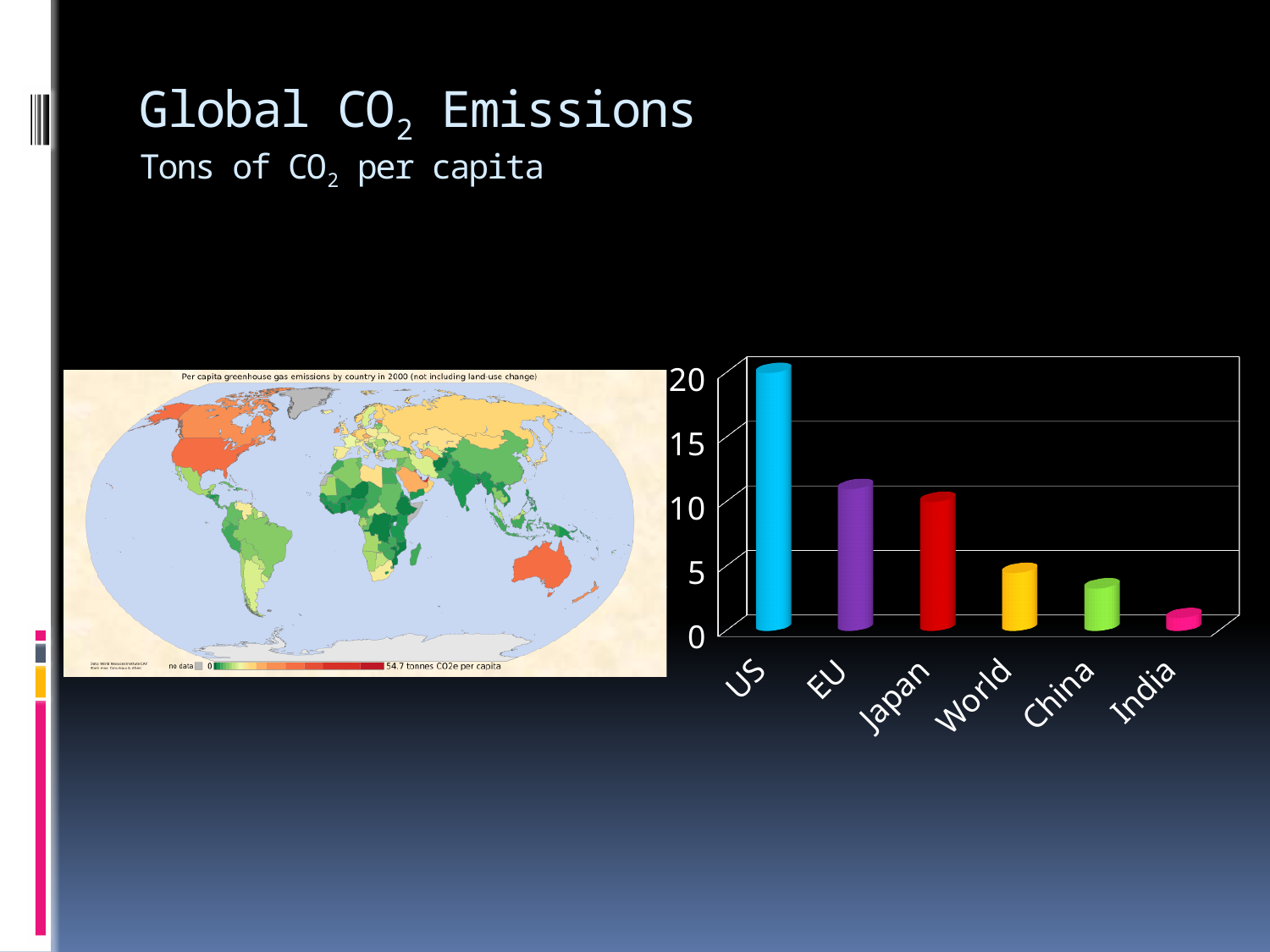
Which category has the lowest value in the bar chart? India Which is larger in the bar chart, the value for EU or the value for India? EU Do the values in the bar chart rise or fall from left to right? fall What kind of chart is shown on the right of the slide? bar chart Is the value for Japan greater or less than 15? less Is the value for US greater or less than 15? greater Which category has the highest value in the bar chart? US Is the value for India greater or less than 5? less Which is larger in the bar chart, the value for US or the value for China? US What unit does the slide subtitle give for the emissions values? Tons of CO2 per capita How many categories are shown on the bar chart? 6